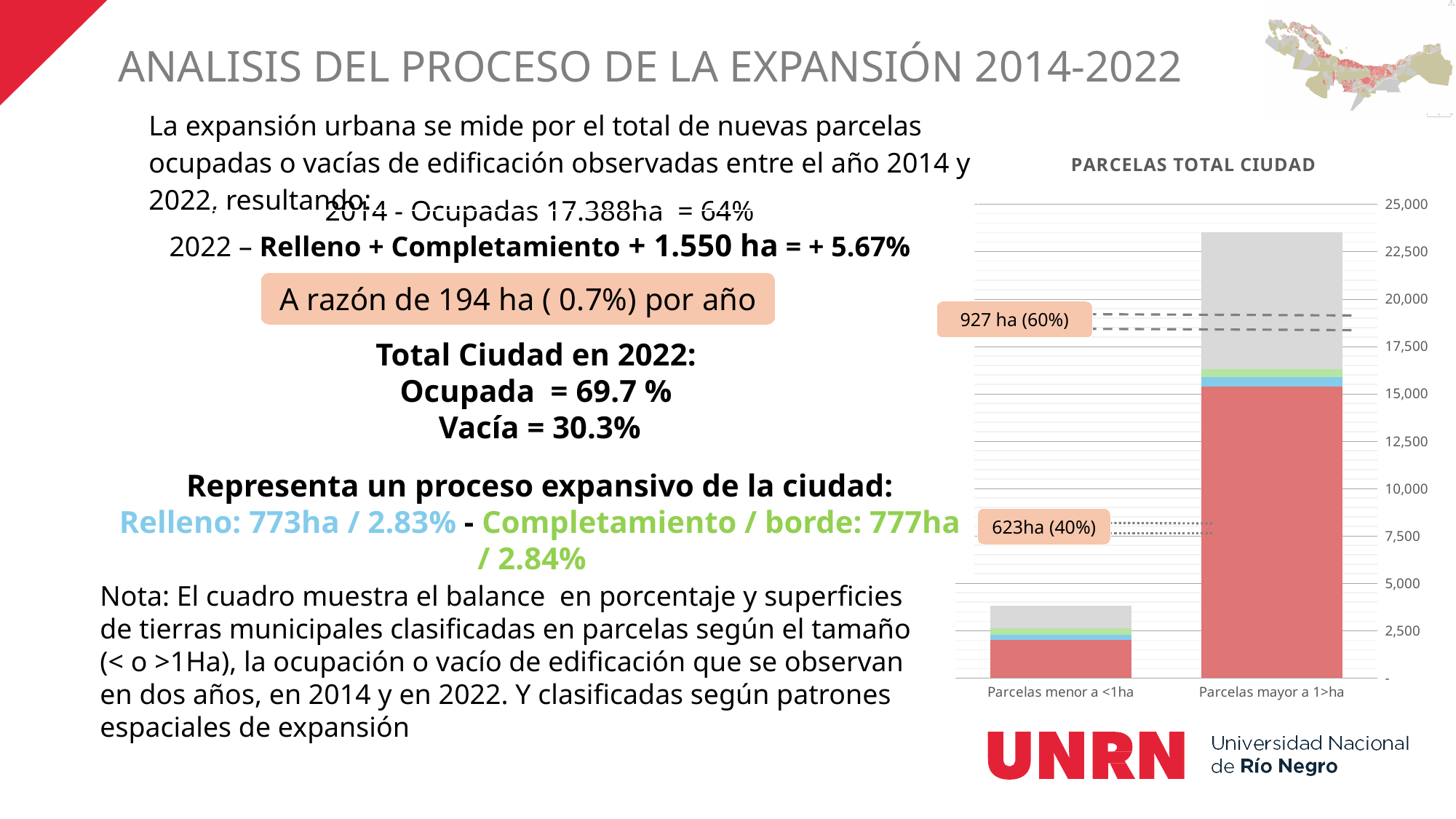
Do the bar totals rise or fall from left to right along the x axis? Rise What is the highest value labelled on the chart's vertical axis? 25,000 Is the red segment of the bar for Parcelas menor a <1ha greater or less than 2,500? less Which bar is taller, Parcelas menor a <1ha or Parcelas mayor a 1>ha? Parcelas mayor a 1>ha Which category has the shortest bar in the chart? Parcelas menor a <1ha Which category has the tallest bar in the chart? Parcelas mayor a 1>ha Is the total height of the bar for Parcelas menor a <1ha greater or less than 5,000? less What kind of chart is shown on the slide? Stacked bar chart Is the red segment of the bar for Parcelas mayor a 1>ha greater or less than 12,500? greater What is the title of the chart on the slide? PARCELAS TOTAL CIUDAD How many categories are shown on the x axis of the chart? 2